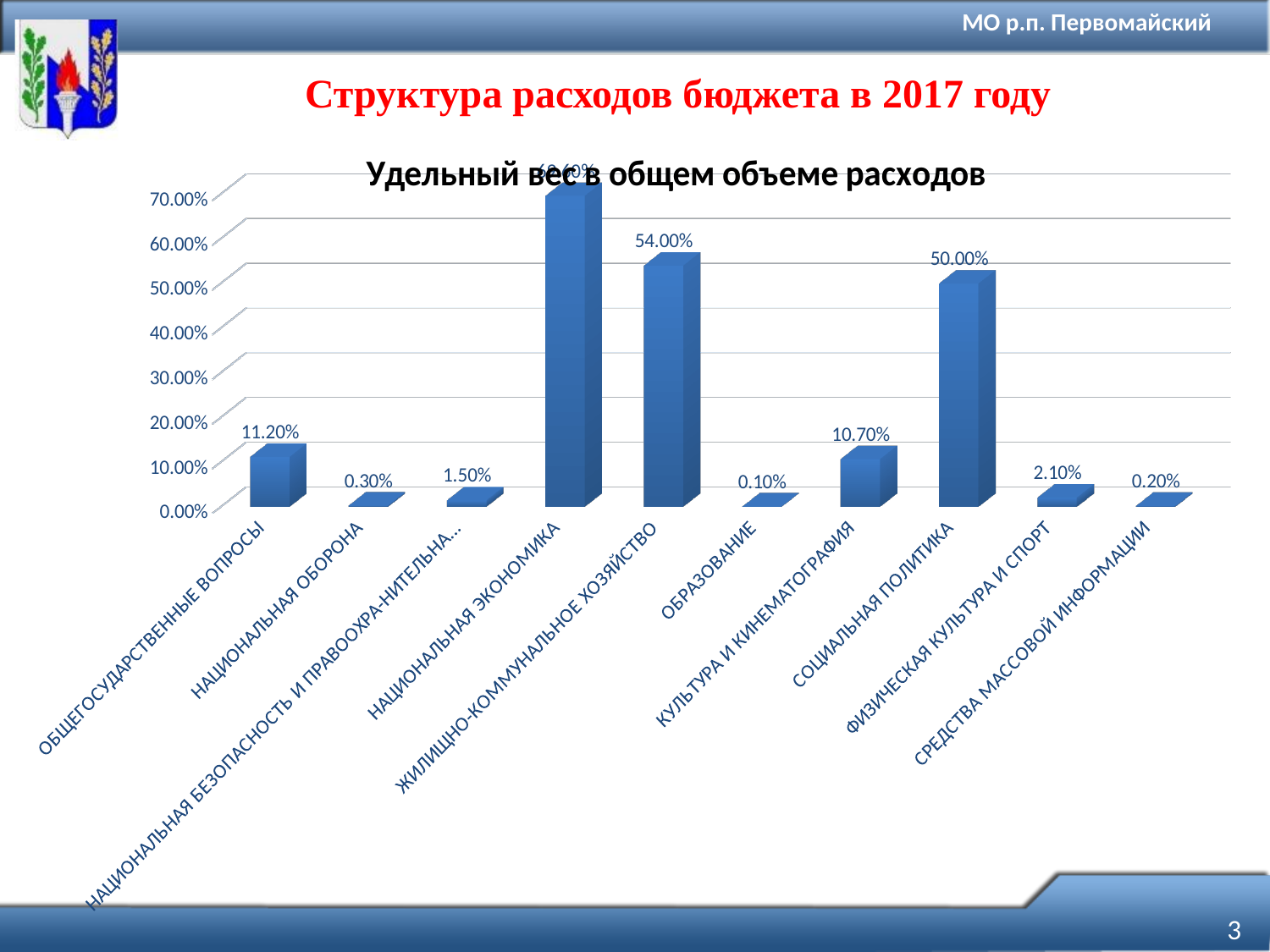
What kind of chart is shown on the slide? bar chart How many categories are shown in the chart? 10 What is the value for СОЦИАЛЬНАЯ ПОЛИТИКА? 50.00% What is the value for ОБЩЕГОСУДАРСТВЕННЫЕ ВОПРОСЫ? 11.20% Is the value for НАЦИОНАЛЬНАЯ ЭКОНОМИКА greater or less than 60.00%? greater Which category has the highest value? НАЦИОНАЛЬНАЯ ЭКОНОМИКА What is the value for КУЛЬТУРА И КИНЕМАТОГРАФИЯ? 10.70% What is the value for ФИЗИЧЕСКАЯ КУЛЬТУРА И СПОРТ? 2.10% What is the difference between the values for ЖИЛИЩНО-КОММУНАЛЬНОЕ ХОЗЯЙСТВО and СОЦИАЛЬНАЯ ПОЛИТИКА? 4.00% What is the value for ЖИЛИЩНО-КОММУНАЛЬНОЕ ХОЗЯЙСТВО? 54.00% Which is larger, the value for ОБЩЕГОСУДАРСТВЕННЫЕ ВОПРОСЫ or the value for КУЛЬТУРА И КИНЕМАТОГРАФИЯ? ОБЩЕГОСУДАРСТВЕННЫЕ ВОПРОСЫ Which category has the lowest value? ОБРАЗОВАНИЕ